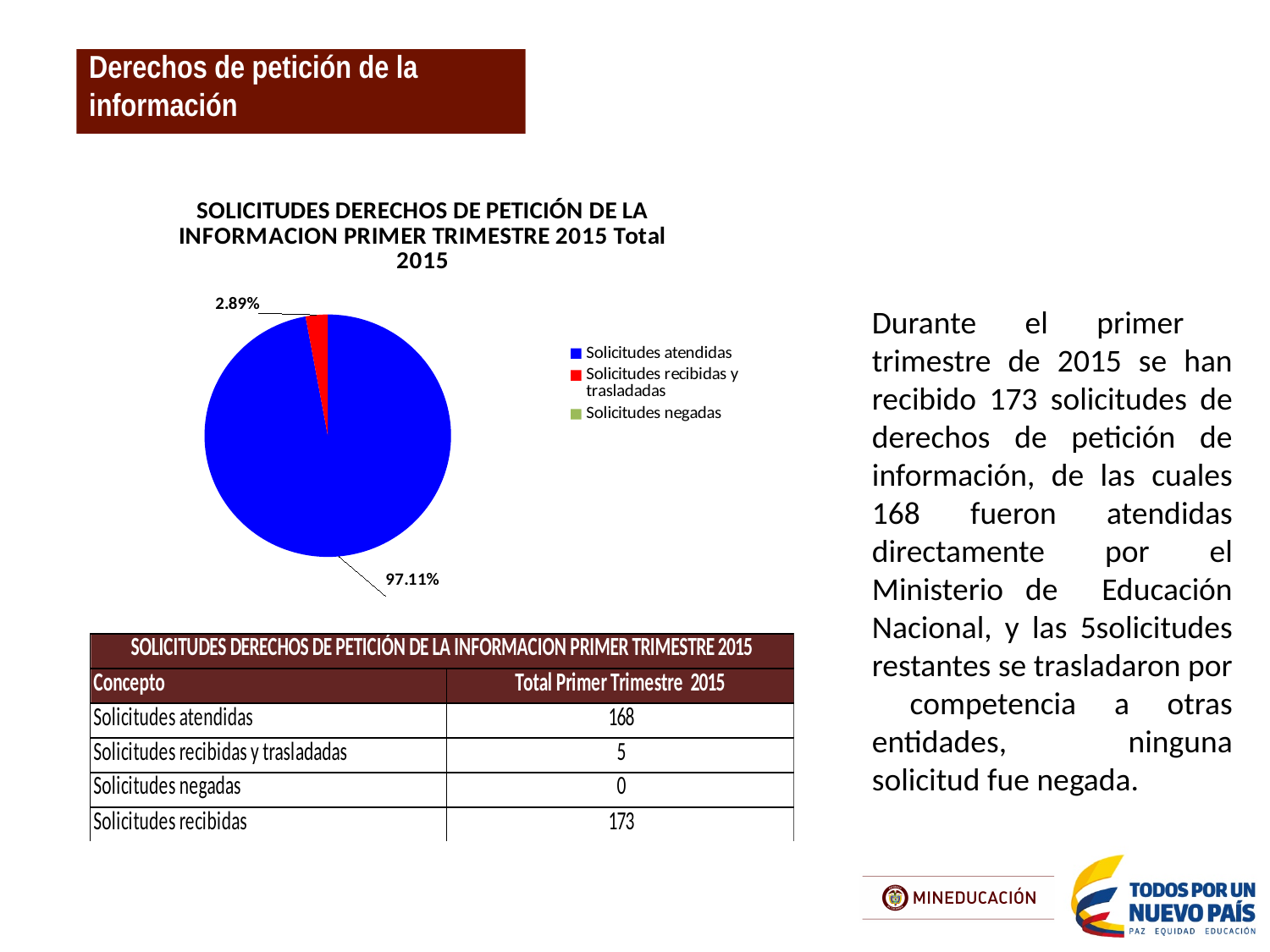
How many entries does the pie chart's legend list? 3 According to the table below the chart, what is the total of Solicitudes recibidas? 173 Which category has the largest slice of the pie? Solicitudes atendidas What kind of chart is shown on the slide? pie chart What is the difference in percentage points between the 97.11% slice and the 2.89% slice? 94.22 Which is larger, the slice for Solicitudes atendidas or the slice for Solicitudes recibidas y trasladadas? Solicitudes atendidas What is the title of the pie chart? SOLICITUDES DERECHOS DE PETICIÓN DE LA INFORMACION PRIMER TRIMESTRE 2015 Total 2015 What colour is the Solicitudes atendidas slice in the pie chart? blue According to the table below the chart, how many Solicitudes atendidas were there in the first quarter of 2015? 168 According to the table below the chart, how many Solicitudes negadas were there? 0 What share of the pie does the Solicitudes atendidas slice represent? 97.11% What share of the pie does the Solicitudes recibidas y trasladadas slice represent? 2.89%